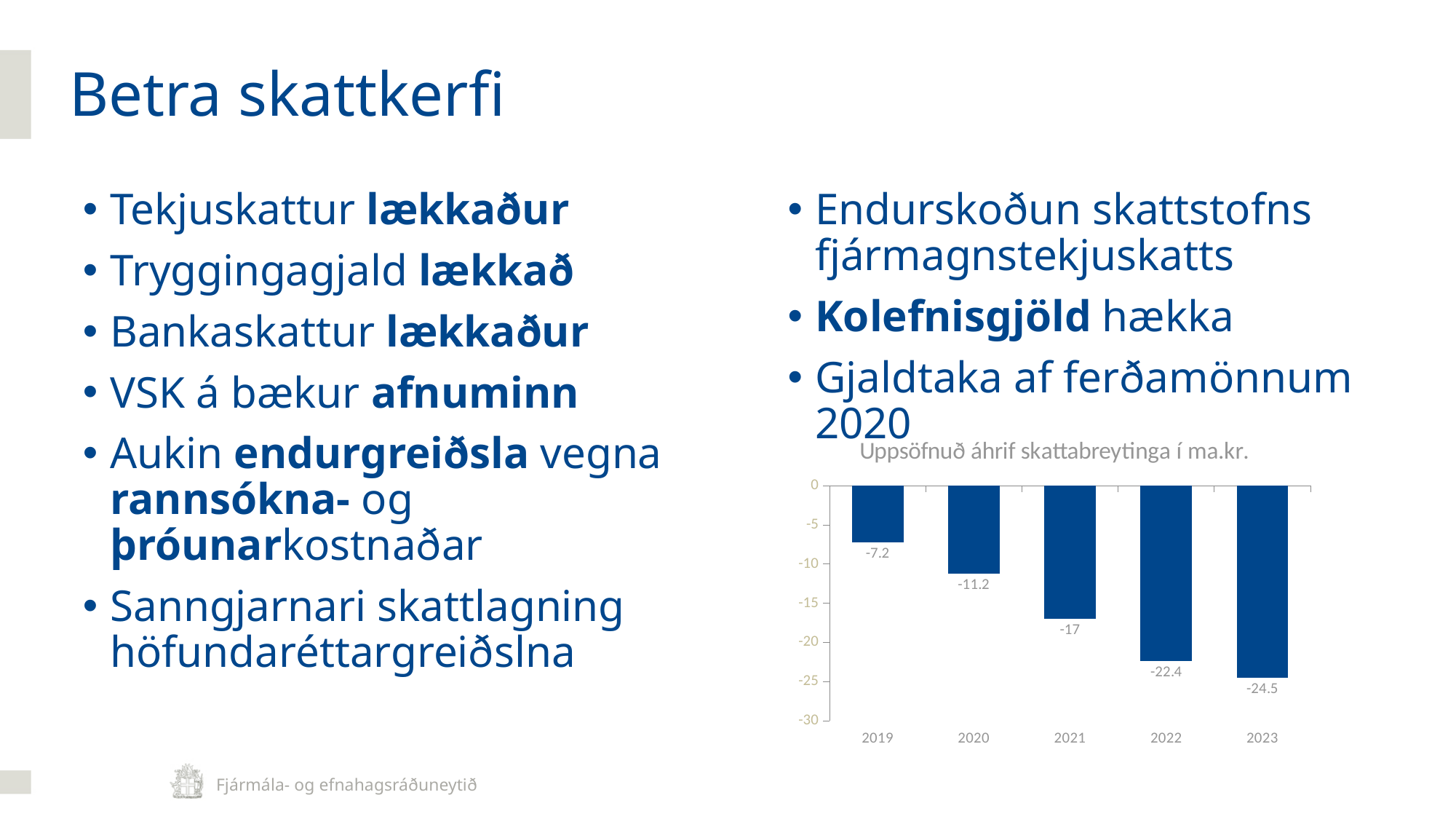
What is the title of the chart? Uppsöfnuð áhrif skattabreytinga í ma.kr. What is the difference between the values for 2022 and 2020? 11.2 What kind of chart is shown on the slide? Bar chart How many years are shown on the x axis of the chart? 5 What is the value for 2020 in the chart? -11.2 Which is larger in magnitude, the value for 2021 or the value for 2022? 2022 Do the values rise or fall from 2019 to 2023? Fall Which year has the highest (least negative) value in the chart? 2019 Which year has the lowest (most negative) value in the chart? 2023 What is the value for 2019 in the chart? -7.2 What is the value for 2021 in the chart? -17 What is the value for 2023 in the chart? -24.5